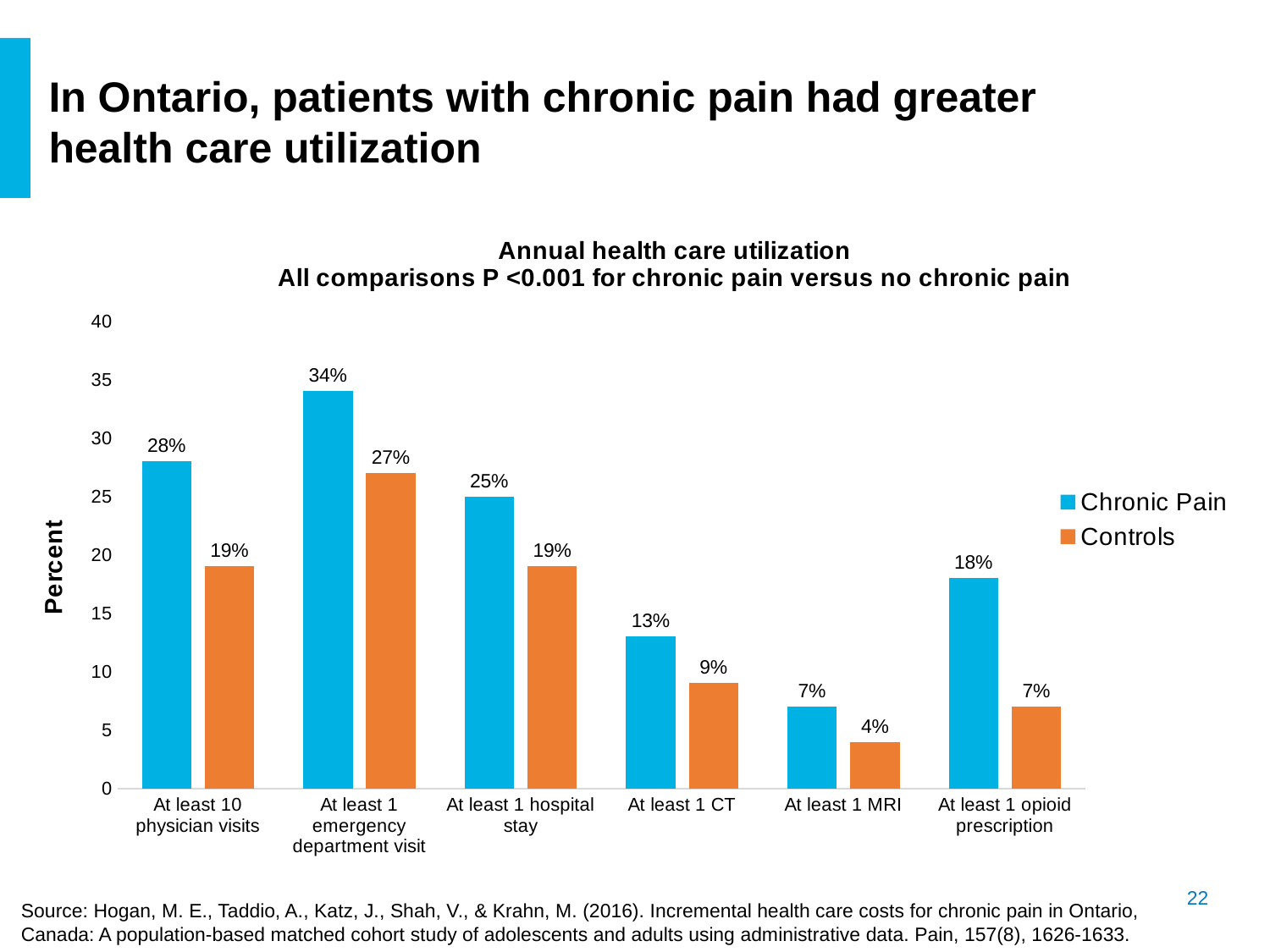
What is the Controls value for 'At least 10 physician visits'? 19% Which category has the highest Chronic Pain value? At least 1 emergency department visit How many series does the legend list? 2 What is the Controls value for 'At least 1 MRI'? 4% What kind of chart is shown on the slide? Bar chart Which is larger: the Controls value for 'At least 1 emergency department visit' or the Chronic Pain value for 'At least 1 hospital stay'? Controls value for 'At least 1 emergency department visit' Which category has the lowest Controls value? At least 1 MRI Which colour represents the Controls series? Orange What is the difference between the Chronic Pain and Controls values for 'At least 1 opioid prescription'? 11% What is the Chronic Pain value for 'At least 1 emergency department visit'? 34% What is the label of the y axis? Percent How many categories are shown on the x axis? 6